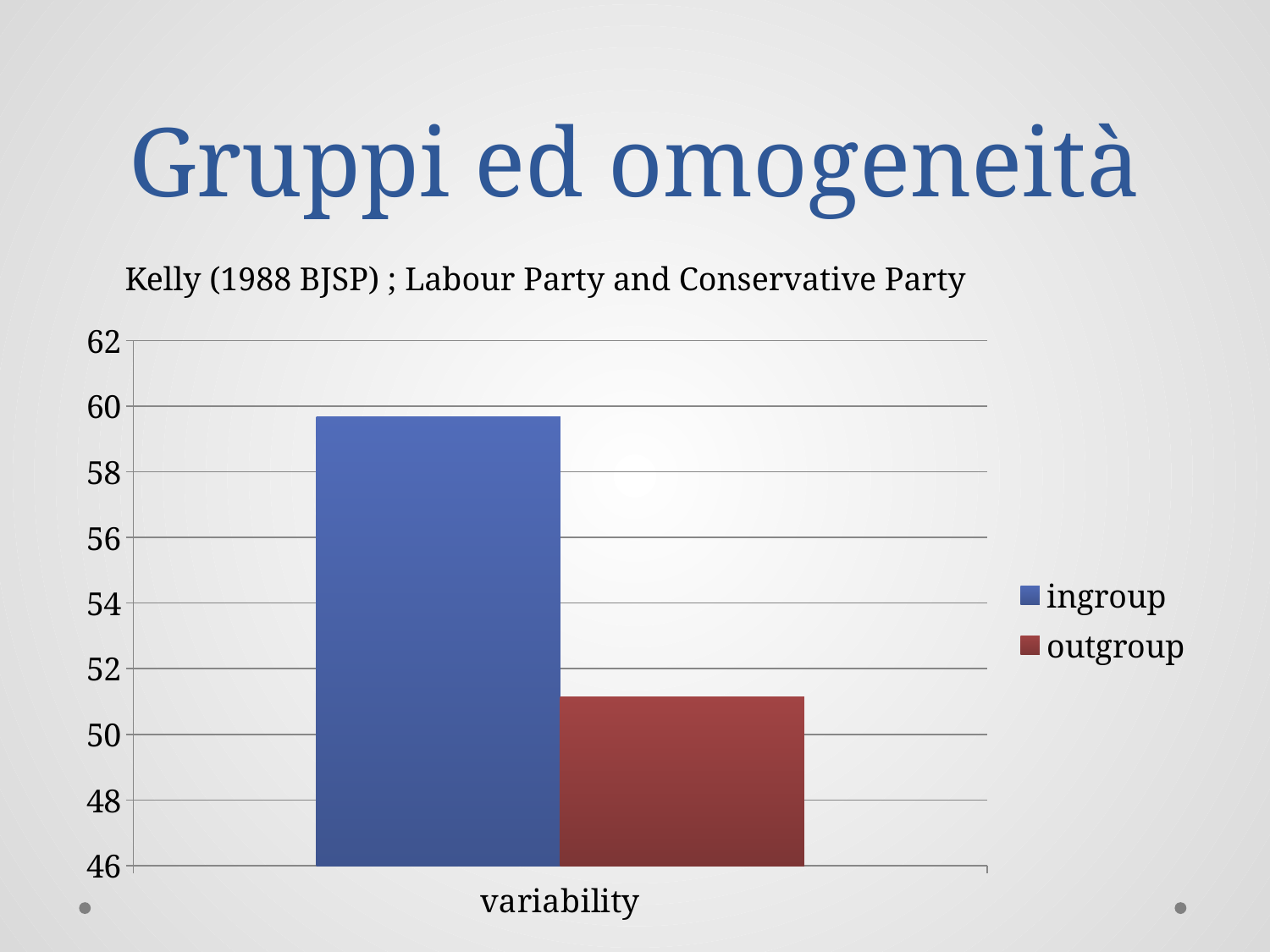
Is the value for outgroup greater or less than 50? greater Which series has the lowest value in the chart? outgroup How many categories are shown on the x axis? 1 Is the value for ingroup greater or less than 58? greater What kind of chart is shown on the slide? bar chart What colour is the bar for the outgroup series? red Which series has the higher value for variability, ingroup or outgroup? ingroup Is the value for outgroup greater or less than 52? less How many series does the legend list? 2 What is the label of the category on the x axis? variability